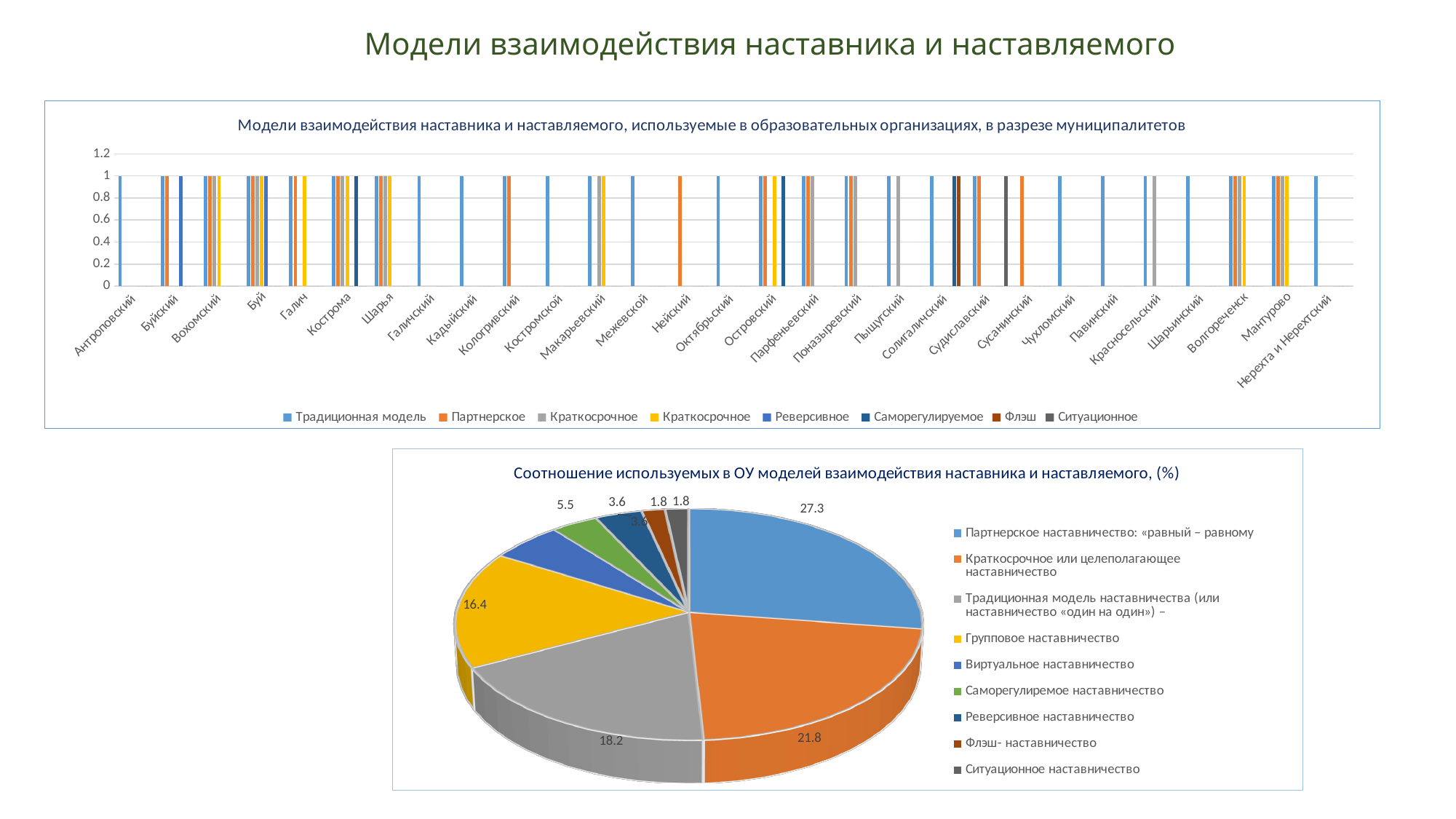
What kind of chart is the top chart on the slide? Bar chart What kind of chart is the bottom chart on the slide? Pie chart In the pie chart at the bottom of the slide, what is the difference between the values for Партнерское наставничество and Краткосрочное или целеполагающее наставничество? 5.5 How many series does the legend of the top chart list? 8 In the pie chart at the bottom of the slide, which model has the largest share? Партнерское наставничество: «равный – равному» How many municipalities (categories) are shown on the x axis of the top chart? 29 In the pie chart at the bottom of the slide, which is larger: Традиционная модель наставничества or Групповое наставничество? Традиционная модель наставничества In the pie chart at the bottom of the slide, what is the value for Групповое наставничество? 16.4 In the top chart, what is the value for Традиционная модель in Антроповский? 1 How many entries does the legend of the pie chart at the bottom of the slide list? 9 In the pie chart at the bottom of the slide, what is the value for Виртуальное наставничество? 5.5 In the pie chart 'Соотношение используемых в ОУ моделей взаимодействия наставника и наставляемого, (%)', what is the value for Партнерское наставничество: «равный – равному»? 27.3